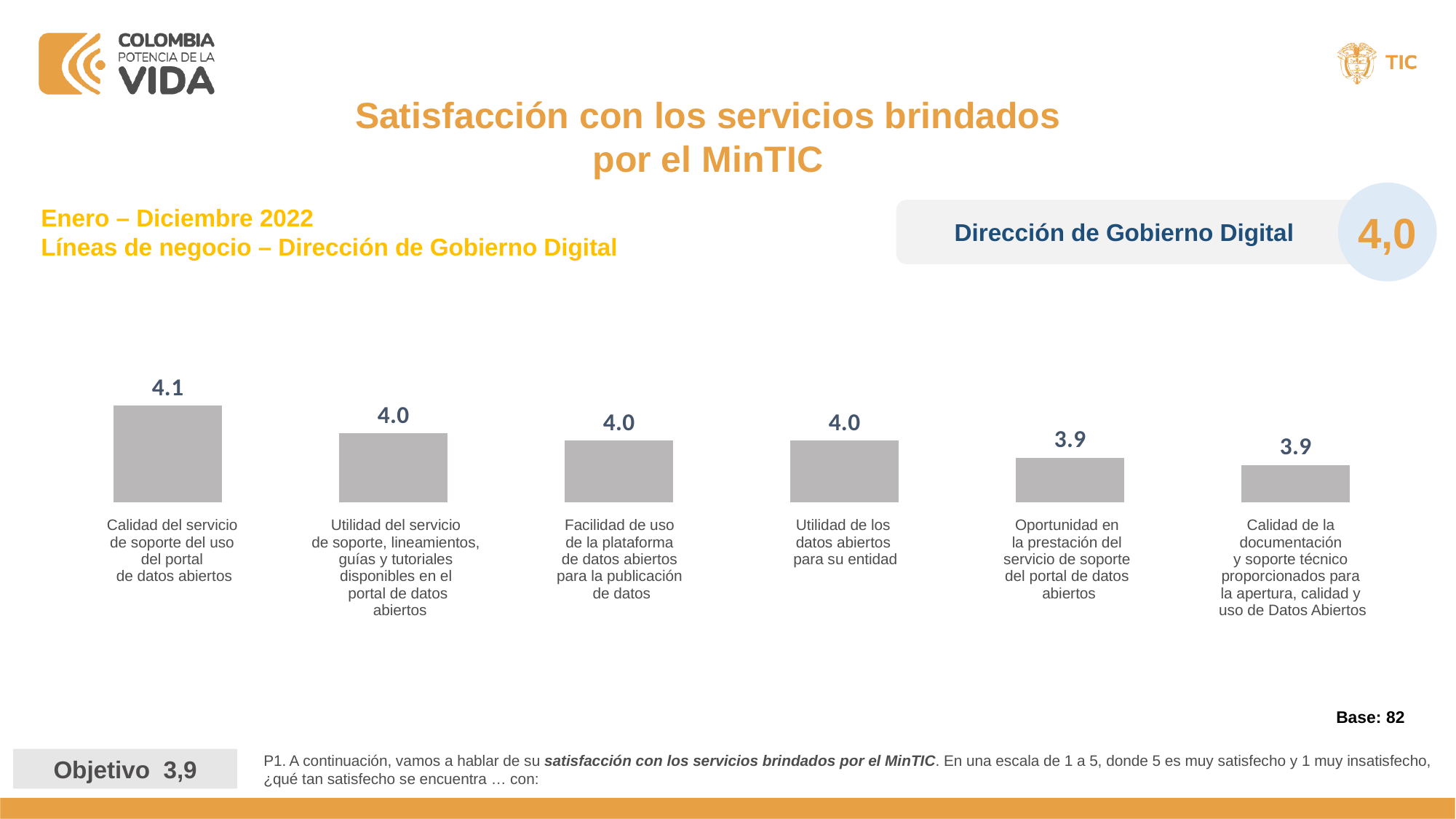
What is the base (number of respondents) shown on the slide? 82 What is the difference between the value for "Calidad del servicio de soporte del uso del portal de datos abiertos" and the value for "Calidad de la documentación y soporte técnico proporcionados para la apertura, calidad y uso de Datos Abiertos"? 0.2 What is the value for "Utilidad de los datos abiertos para su entidad"? 4.0 How many categories are shown in the chart? 6 What is the value for "Calidad del servicio de soporte del uso del portal de datos abiertos"? 4.1 Do the values rise or fall from left to right across the chart? Fall What is the value for "Facilidad de uso de la plataforma de datos abiertos para la publicación de datos"? 4.0 What is the value for "Oportunidad en la prestación del servicio de soporte del portal de datos abiertos"? 3.9 Which category has the highest value? Calidad del servicio de soporte del uso del portal de datos abiertos Which is larger: the value for "Utilidad del servicio de soporte, lineamientos, guías y tutoriales disponibles en el portal de datos abiertos" or the value for "Oportunidad en la prestación del servicio de soporte del portal de datos abiertos"? Utilidad del servicio de soporte, lineamientos, guías y tutoriales disponibles en el portal de datos abiertos What is the overall score shown for Dirección de Gobierno Digital on the slide? 4,0 What kind of chart is shown on the slide? Bar chart